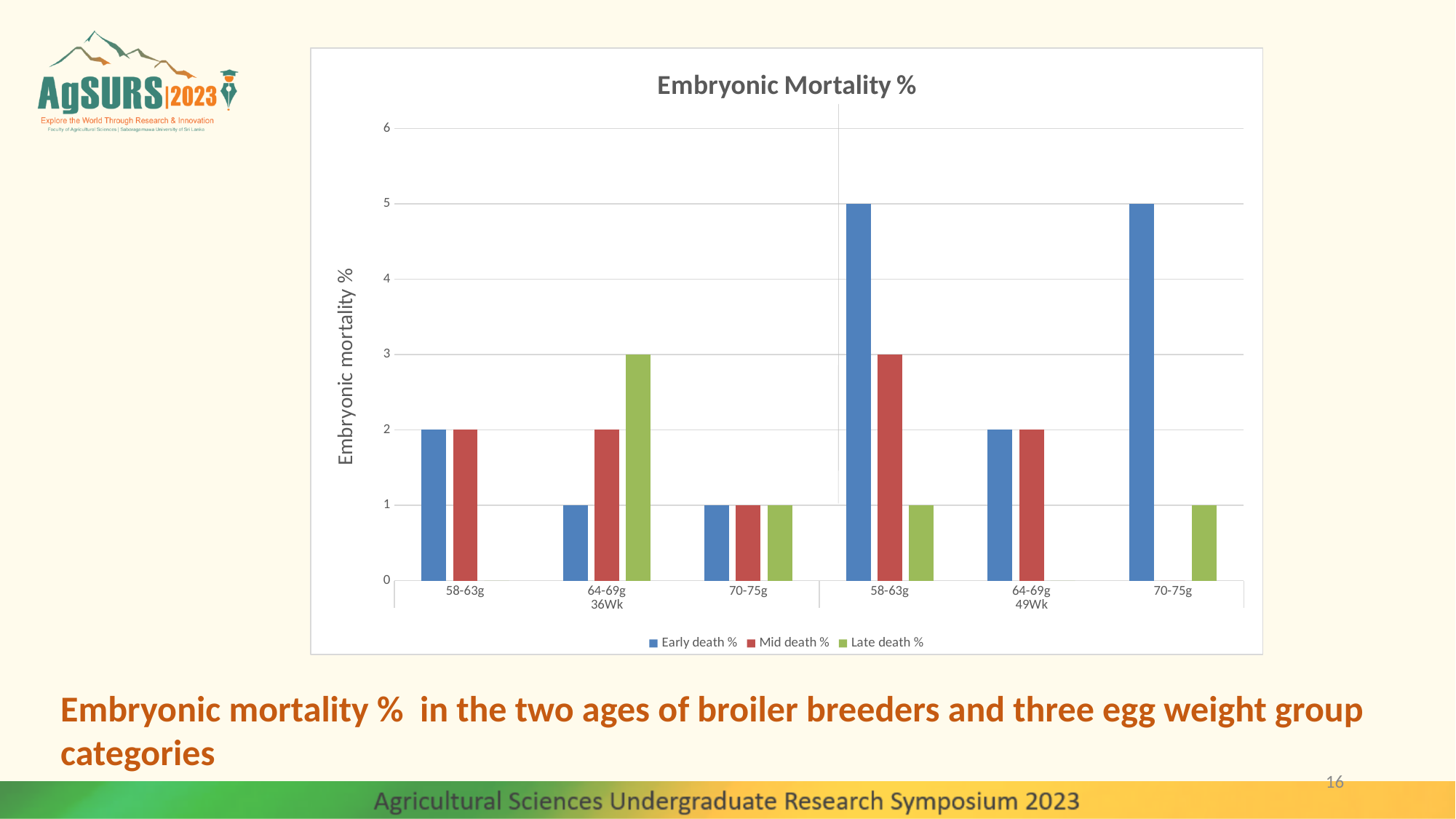
How many series does the legend list? 3 Which is larger, the Early death % for 70-75g at 49Wk or the Early death % for 70-75g at 36Wk? Early death % for 70-75g at 49Wk Is the Early death % value for the 58-63g group at 49Wk greater or less than 4? greater How many egg weight categories are plotted along the x axis in total? 6 What is the difference between the Early death % and Mid death % values for the 58-63g group at 49Wk? 2 What kind of chart is shown on the slide? bar chart What is the Late death % value for the 64-69g group at 36Wk? 3 Which series has the highest value for the 64-69g group at 36Wk? Late death % What is the title of the chart? Embryonic Mortality % What is the Early death % value for the 58-63g group at 49Wk? 5 What is the label on the vertical axis of the chart? Embryonic mortality % What is the Mid death % value for the 58-63g group at 49Wk? 3